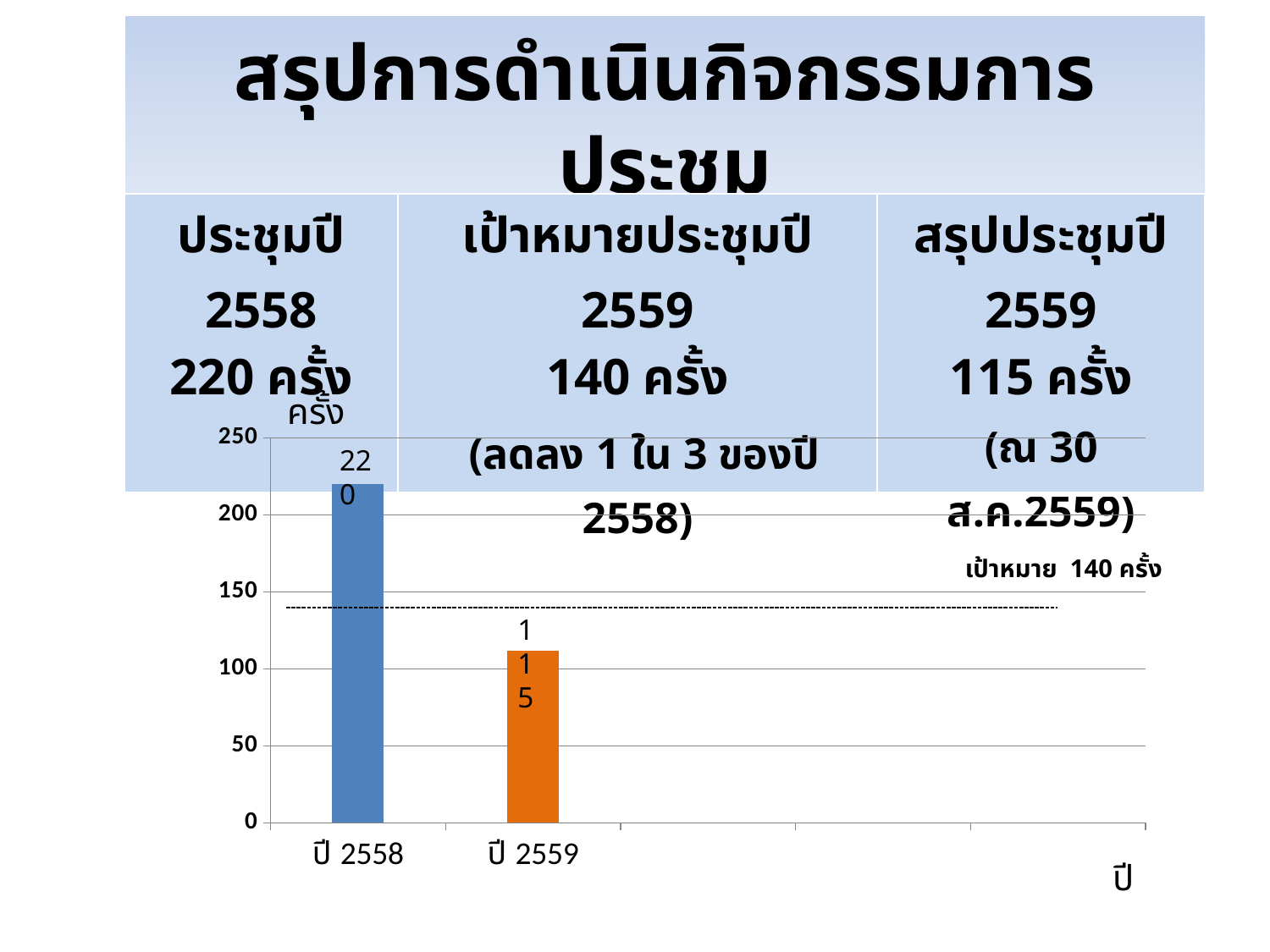
Which year has the highest bar? ปี 2558 Is the value for ปี 2558 greater or less than 200? greater What is the value for ปี 2558? 220 How many bars are plotted in the chart? 2 What kind of chart is shown on the slide? bar chart Do the values rise or fall from ปี 2558 to ปี 2559? fall Which is larger, the value for ปี 2558 or ปี 2559? ปี 2558 Is the value for ปี 2559 greater or less than 150? less What is the value for ปี 2559? 115 Which year has the lowest bar? ปี 2559 What target value does the dashed horizontal line in the chart mark? 140 ครั้ง What is the difference between the values for ปี 2558 and ปี 2559? 105